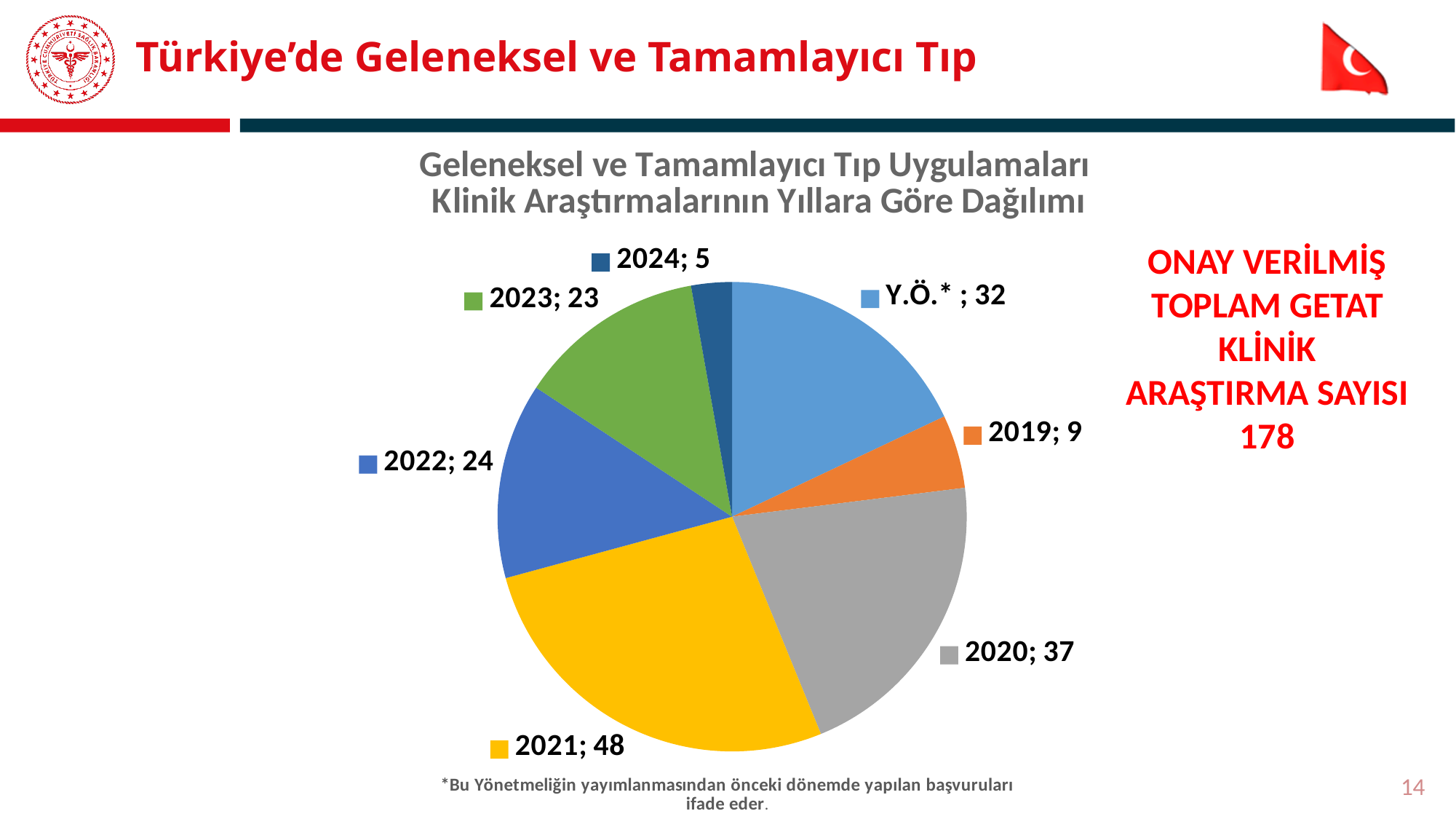
What is the total number of approved GETAT clinical studies stated on the slide? 178 What is the difference between the values for 2022 and 2023? 1 Which category has the largest slice of the pie? 2021 What type of chart is shown on the slide? pie chart What is the value shown for the Y.Ö.* category? 32 Which is larger, the value for 2020 or the value for Y.Ö.*? 2020 Which category has the smallest slice of the pie? 2024 What colour is the slice for 2021? yellow How many clinical studies are shown for 2021? 48 How many categories (slices) does the pie chart have? 7 What is the difference between the values for 2021 and 2020? 11 What is the value shown for 2019? 9